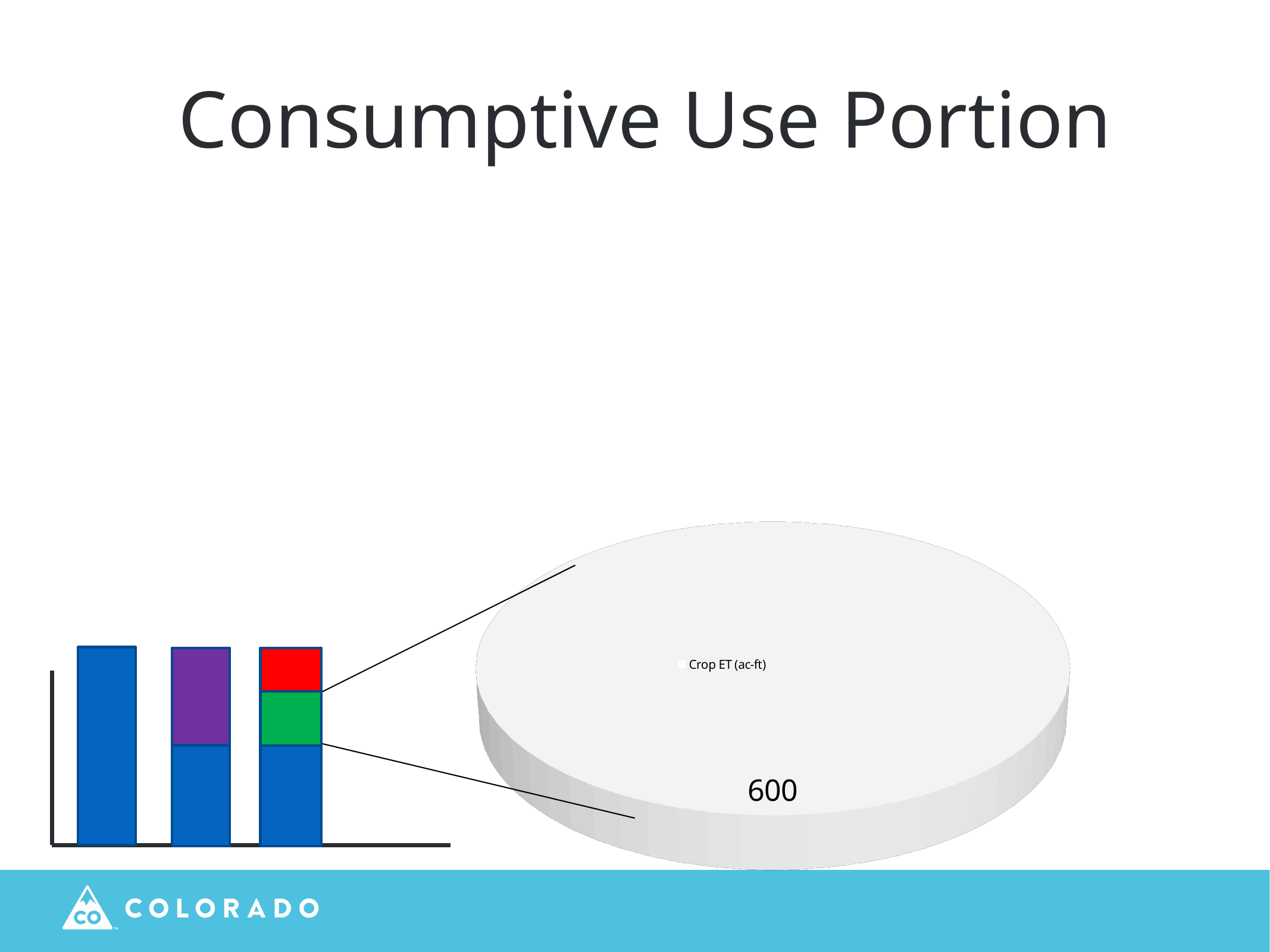
What is the title of the slide? Consumptive Use Portion In the pie chart on the right, what share of the pie does the Crop ET (ac-ft) slice represent? 100% How many slices does the pie chart on the right have? 1 How many bars does the bar chart on the left have? 3 How many entries does the legend of the pie chart on the right list? 1 In the pie chart on the right, what is the value for Crop ET (ac-ft)? 600 What type of chart is shown on the left side of the slide? bar chart In the pie chart on the right, what value is printed on the slice? 600 What type of chart is shown on the right side of the slide? pie chart What is the legend entry of the pie chart on the right? Crop ET (ac-ft) In the bar chart on the left, how many coloured segments make up the rightmost bar? 3